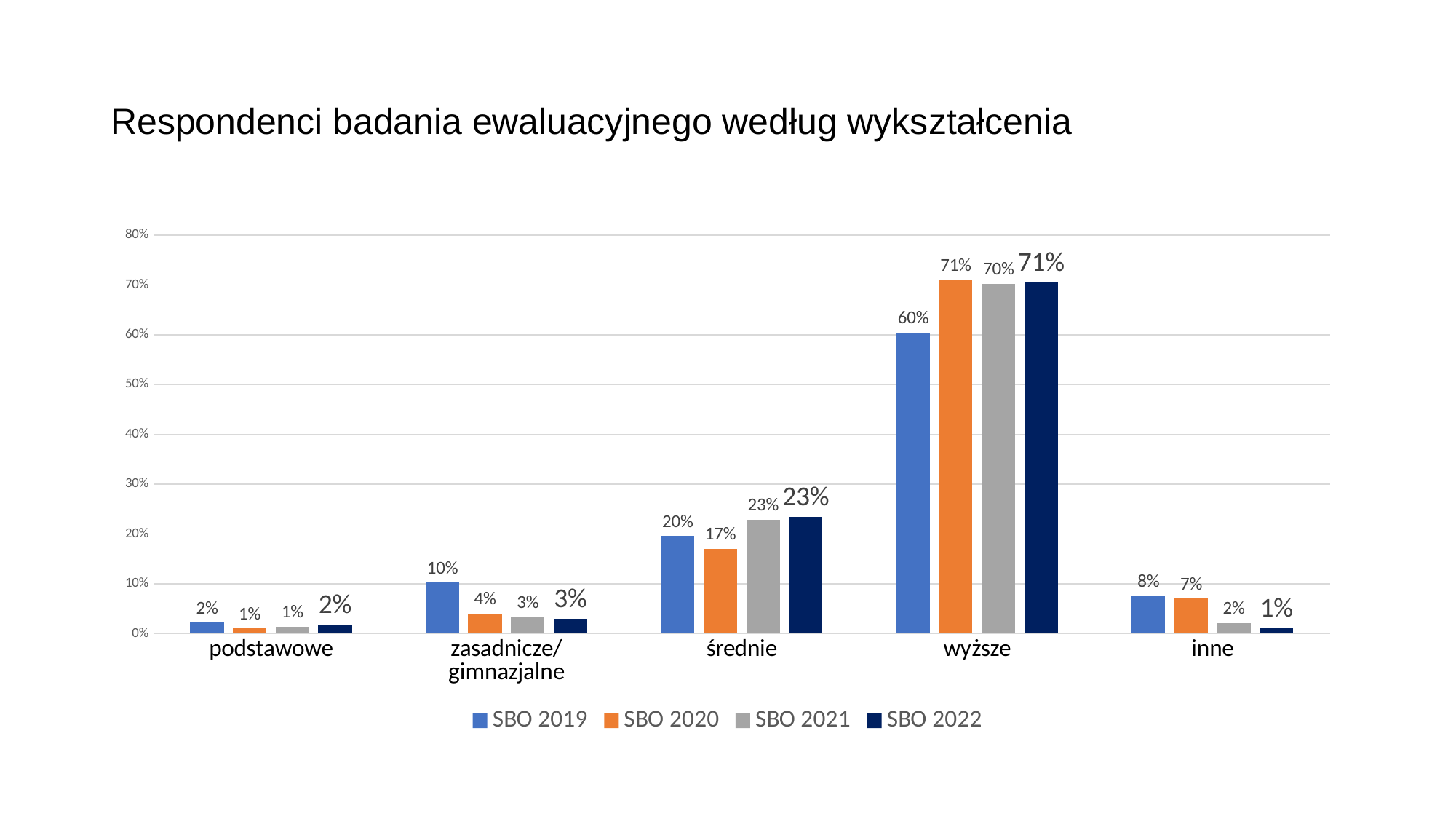
What kind of chart is shown on the slide? bar chart What is the value for 'wyższe' in the SBO 2019 series? 60% What is the difference between the SBO 2019 and SBO 2020 values for 'wyższe'? 11% Which category has the highest value in the SBO 2022 series? wyższe What is the value for 'inne' in the SBO 2021 series? 2% What is the value for 'zasadnicze/gimnazjalne' in the SBO 2022 series? 3% Which category has the lowest value in the SBO 2019 series? podstawowe How many categories are shown on the x axis? 5 How many series does the legend list? 4 What is the title of the chart? Respondenci badania ewaluacyjnego według wykształcenia Which is larger for 'zasadnicze/gimnazjalne': the SBO 2019 value or the SBO 2020 value? SBO 2019 What is the value for 'średnie' in the SBO 2020 series? 17%